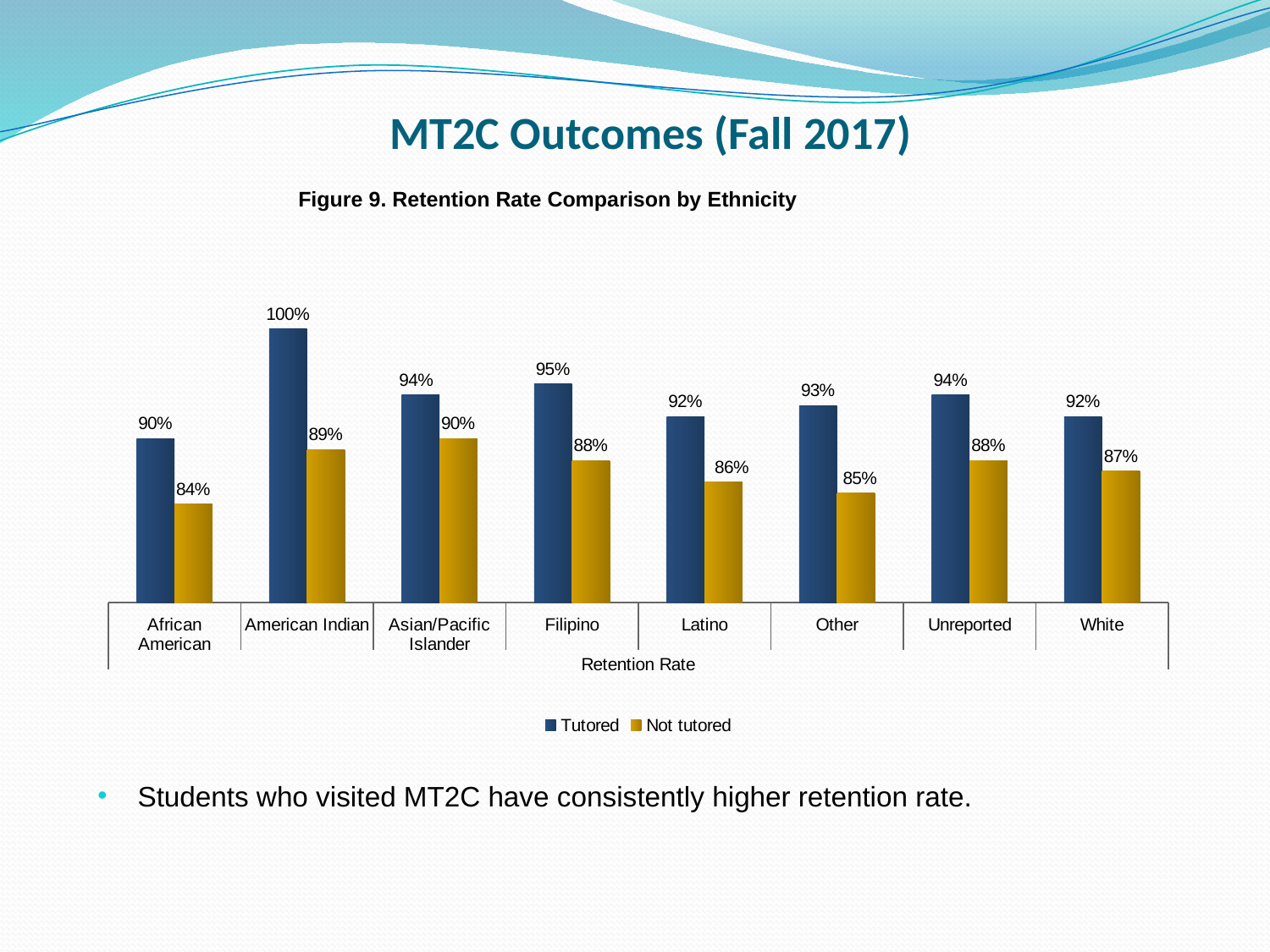
What is the Not tutored retention rate for African American students? 84% Which is larger for Latino students, the Tutored or the Not tutored retention rate? Tutored Which ethnicity has the lowest Not tutored retention rate? African American What is the Tutored retention rate for American Indian students? 100% How many ethnicity categories are shown on the x axis? 8 Which ethnicity has the highest Tutored retention rate? American Indian What type of chart is shown on the slide? Bar chart What is the Tutored retention rate for Filipino students? 95% What is the difference between the Tutored and Not tutored retention rates for Other students? 8% What is the title of the figure? Figure 9. Retention Rate Comparison by Ethnicity How many series does the legend list? 2 What is the Not tutored retention rate for White students? 87%